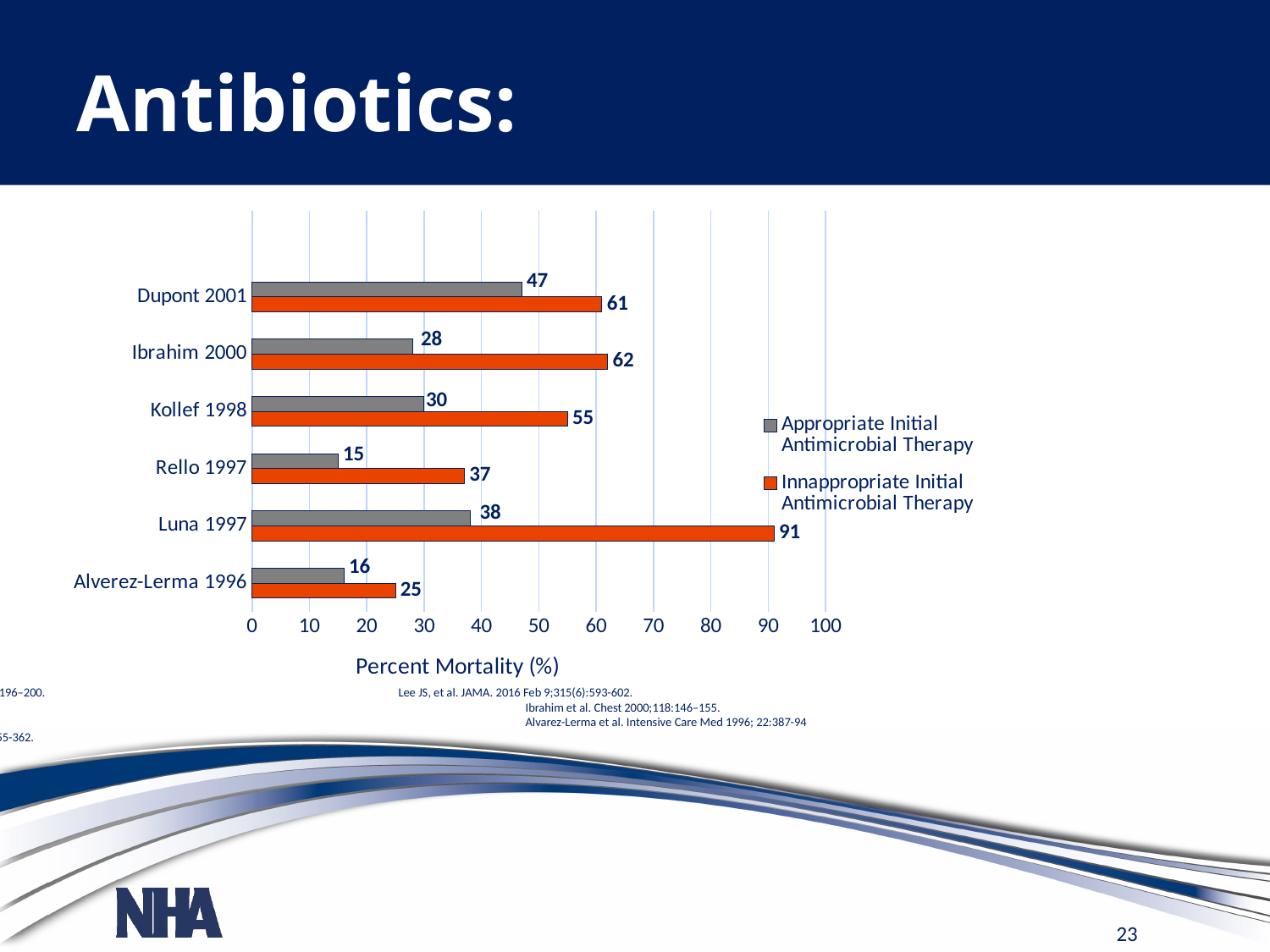
What is the percent mortality for Inappropriate Initial Antimicrobial Therapy in Luna 1997? 91 How many studies are shown on the chart? 6 What is the percent mortality for Inappropriate Initial Antimicrobial Therapy in Kollef 1998? 55 What is the percent mortality for Appropriate Initial Antimicrobial Therapy in Dupont 2001? 47 Which is larger: the Appropriate Initial Antimicrobial Therapy mortality for Luna 1997 or for Kollef 1998? Luna 1997 Is the Inappropriate Initial Antimicrobial Therapy value for Alverez-Lerma 1996 greater or less than 30? less What kind of chart is shown on the slide? Bar chart Which study has the highest percent mortality for Inappropriate Initial Antimicrobial Therapy? Luna 1997 How many series does the legend list? 2 What is the difference between Inappropriate and Appropriate Initial Antimicrobial Therapy mortality in Ibrahim 2000? 34 What is the label of the horizontal axis? Percent Mortality (%) Which study has the lowest percent mortality for Appropriate Initial Antimicrobial Therapy? Rello 1997